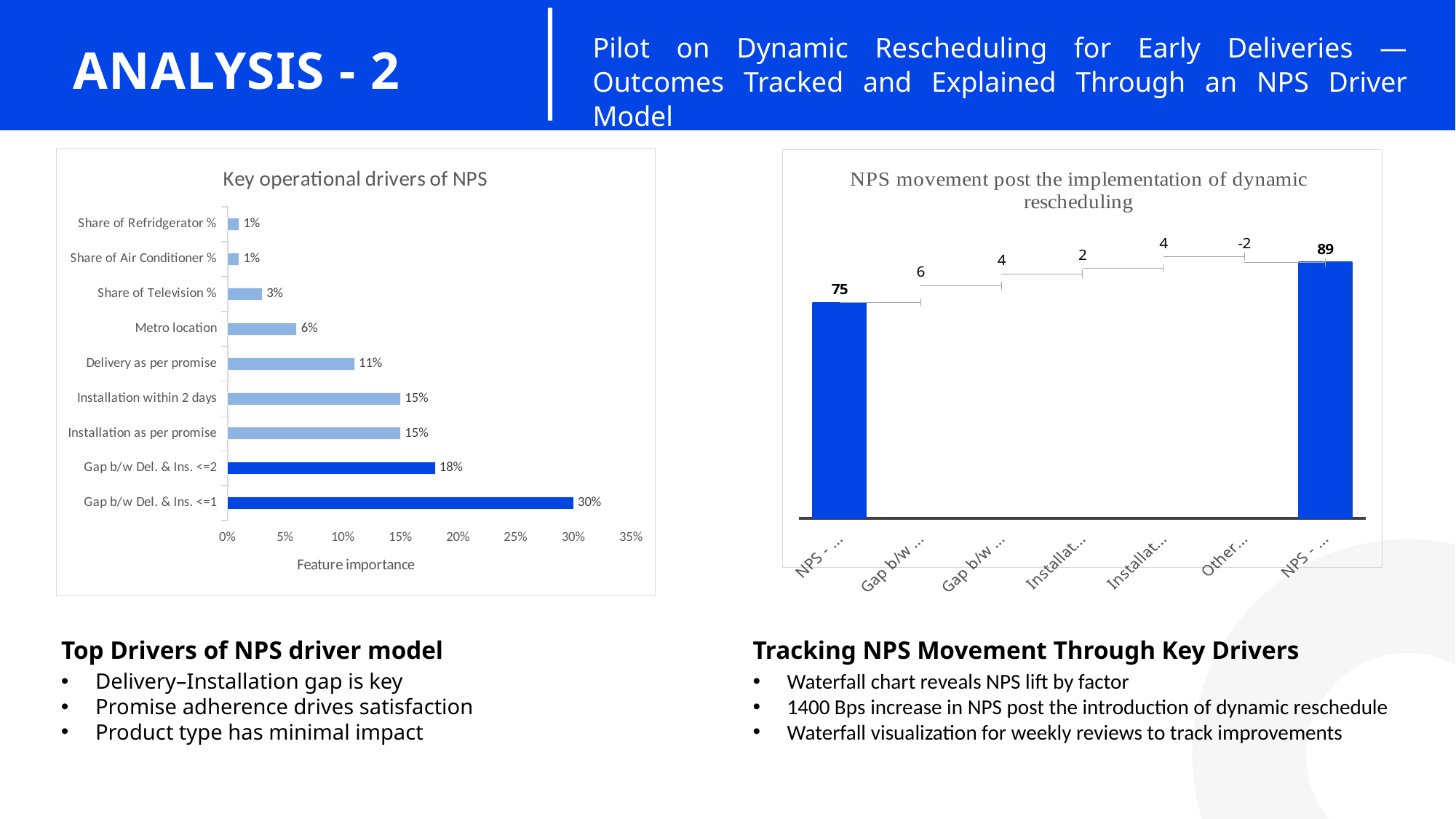
What is the x-axis title of the 'Key operational drivers of NPS' chart? Feature importance In the 'Key operational drivers of NPS' chart, which has a larger feature importance: 'Share of Television %' or 'Metro location'? Metro location In the 'Key operational drivers of NPS' chart, which category has the highest feature importance? Gap b/w Del. & Ins. <=1 What type of chart is 'Key operational drivers of NPS'? Bar chart In the 'NPS movement post the implementation of dynamic rescheduling' chart, what is the value of the first (starting) bar? 75 In the 'NPS movement post the implementation of dynamic rescheduling' chart, what is the value of the last (ending) bar? 89 In the 'NPS movement post the implementation of dynamic rescheduling' chart, what is the difference between the ending bar value and the starting bar value? 14 In the 'Key operational drivers of NPS' chart, what is the feature importance for 'Gap b/w Del. & Ins. <=1'? 30% How many categories are shown in the 'Key operational drivers of NPS' chart? 9 In the 'Key operational drivers of NPS' chart, what is the difference in feature importance between 'Gap b/w Del. & Ins. <=1' and 'Gap b/w Del. & Ins. <=2'? 12% In the 'Key operational drivers of NPS' chart, what is the feature importance for 'Delivery as per promise'? 11% In the 'Key operational drivers of NPS' chart, what is the feature importance for 'Metro location'? 6%